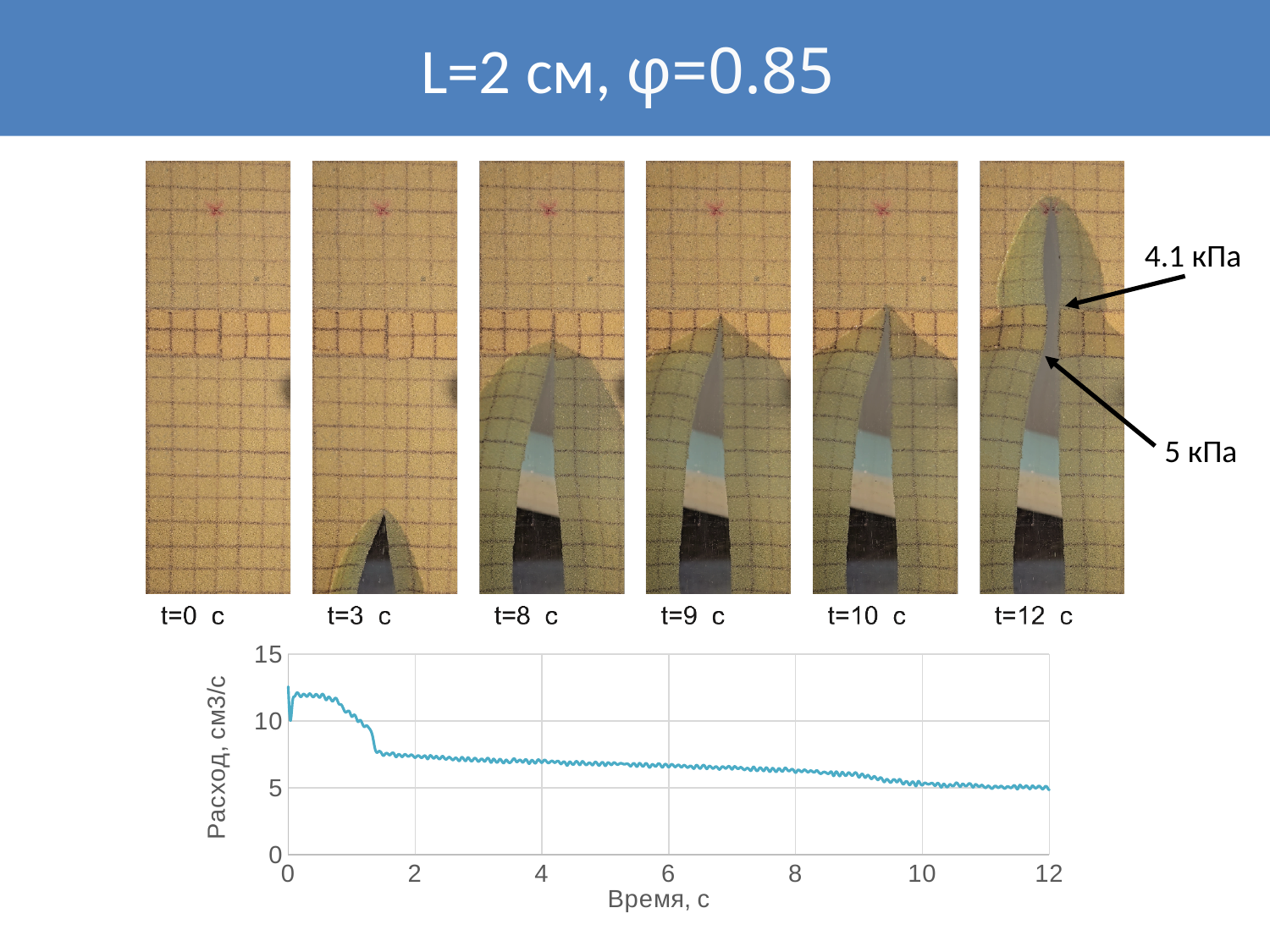
Is the flow rate at time 6 s greater or less than 5 см3/с? greater Overall, does the flow rate (Расход) rise or fall as time increases from 0 to 12 s? fall Is the flow rate at time 6 s greater or less than 10 см3/с? less Which is larger, the flow rate at time 0.5 s or the flow rate at time 10 s? time 0.5 s What is the label of the y axis of the chart? Расход, см3/с What is the maximum value shown on the y axis of the chart? 15 Is the flow rate at time 12 s greater or less than 10 см3/с? less What kind of chart is shown at the bottom of the slide? line chart What is the label of the x axis of the chart? Время, с How many data series are plotted on the chart? 1